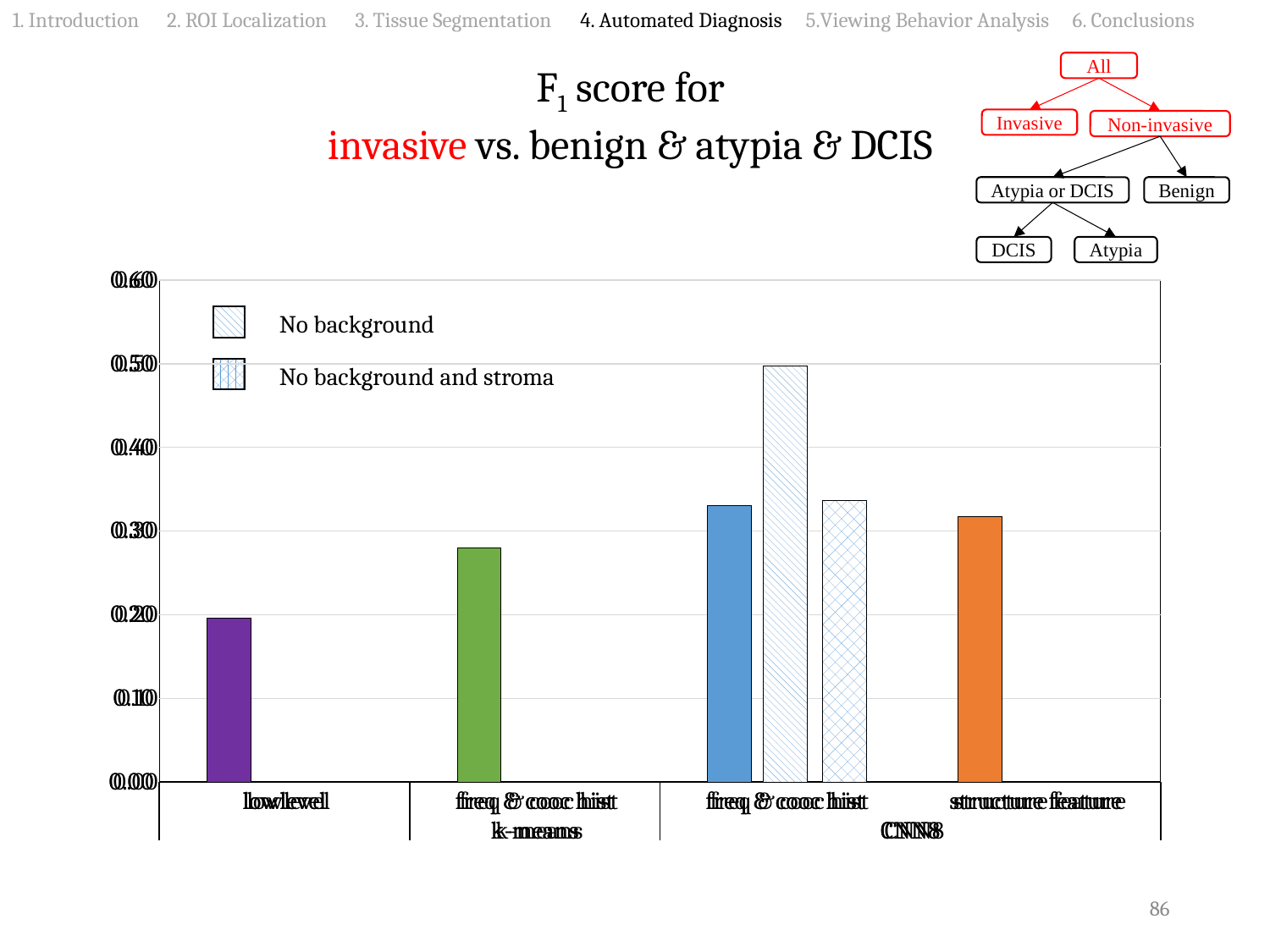
Is the value for low level greater or less than 0.10? greater What kind of chart is shown on the slide? bar chart Which bar is the tallest in the chart? No background (freq & cooc hist, CNN8) Which is larger, the bar for low level or the bar for freq & cooc hist under k-means? freq & cooc hist under k-means What are the two legend entries in the chart? No background; No background and stroma Is the value of the No background bar for freq & cooc hist under CNN8 greater or less than 0.40? greater For freq & cooc hist under CNN8, which is larger, the No background bar or the No background and stroma bar? No background Is the value for freq & cooc hist under k-means greater or less than 0.30? less How many entries does the chart legend list? 2 How many category labels are shown along the x axis? 4 Which category has the lowest bar in the chart? lowlevel